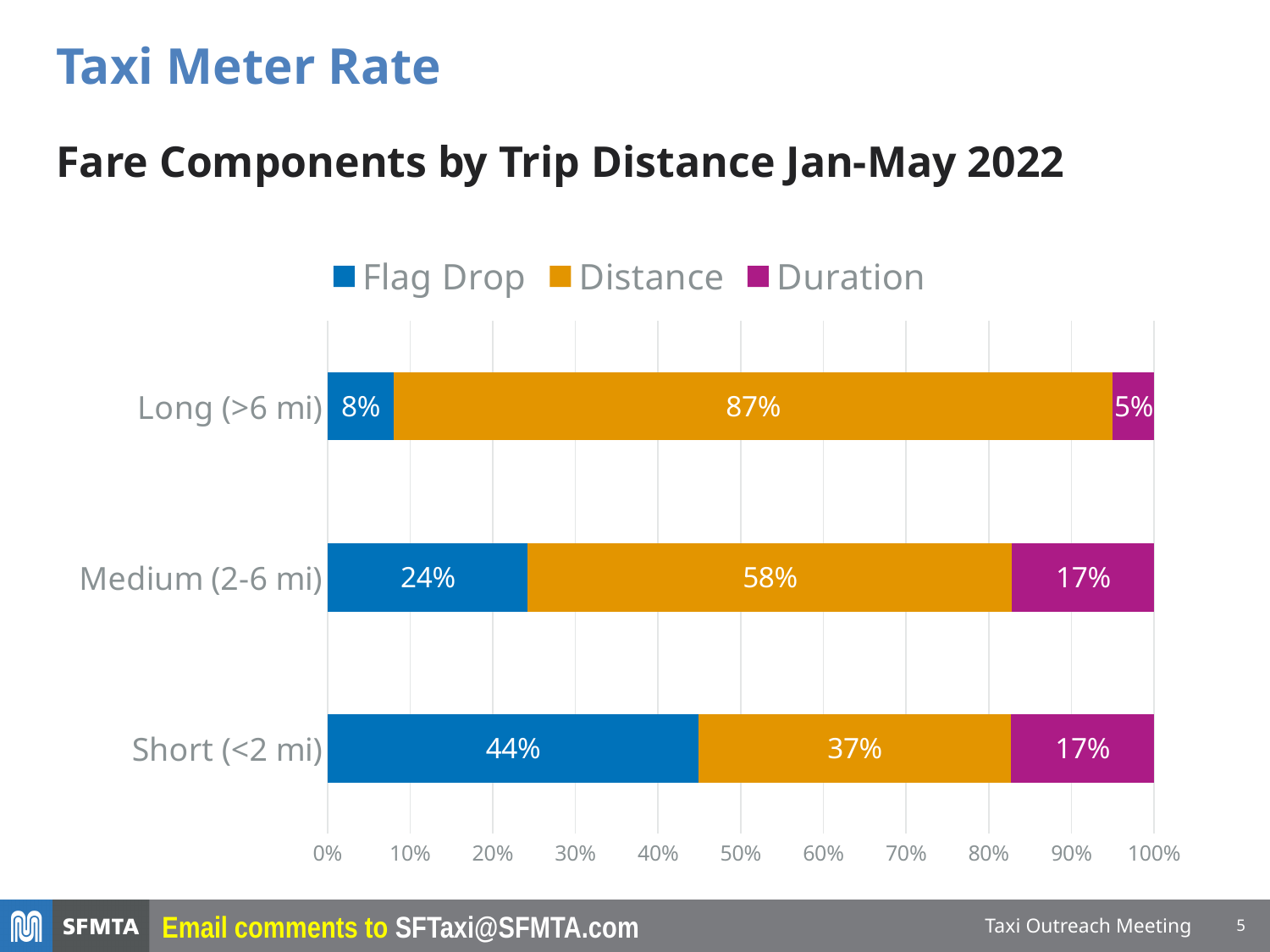
What is the Flag Drop share for Medium (2-6 mi) trips? 24% What is the Distance share for Long (>6 mi) trips? 87% What is the difference between the Flag Drop share for Short (<2 mi) trips and for Medium (2-6 mi) trips? 20% What is the Flag Drop share for Short (<2 mi) trips? 44% Which is larger for Short (<2 mi) trips: the Flag Drop share or the Distance share? Flag Drop Which trip distance category has the lowest Flag Drop share? Long (>6 mi) Which trip distance category has the highest Distance share? Long (>6 mi) Which colour represents Duration in the chart? Purple How many series does the legend list? 3 What kind of chart is shown on the slide? Stacked bar chart How many trip distance categories are shown in the chart? 3 What is the Duration share for Medium (2-6 mi) trips? 17%